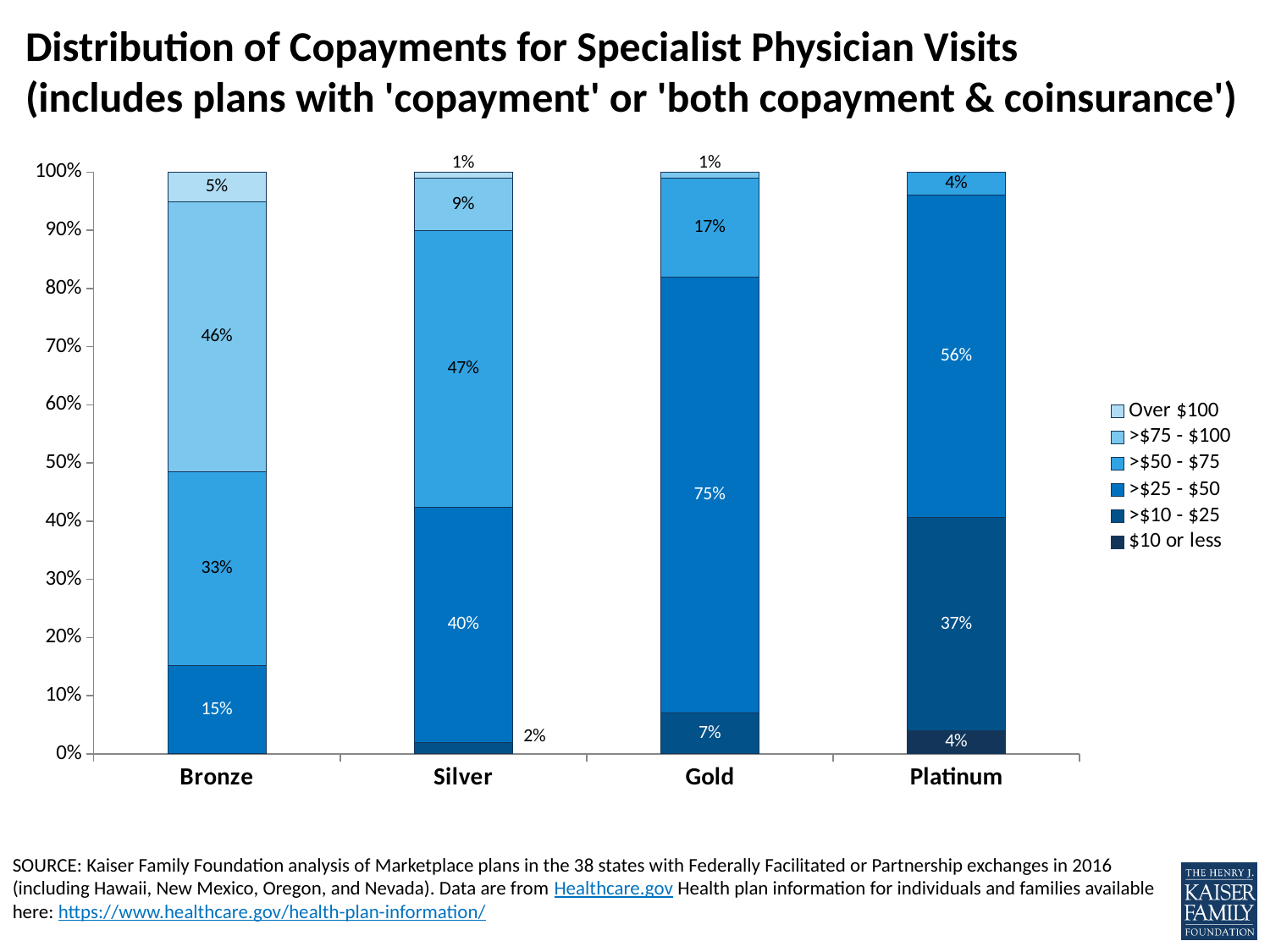
What is the value of the bottom segment of the Bronze bar? 15% What is the value of the bottom segment of the Platinum bar? 4% What is the difference between the largest segment in the Gold bar (75%) and the largest segment in the Platinum bar (56%)? 19 percentage points What is the value of the smallest segment in the Silver bar? 1% How many plan categories are shown on the x axis? 4 What is the first entry listed in the legend? Over $100 What is the value of the largest segment in the Platinum bar? 56% Which plan has the largest single segment in its bar? Gold What kind of chart is shown on the slide? Stacked bar chart What is the value of the largest segment in the Gold bar? 75% Which is larger: the 46% segment in the Bronze bar or the 47% segment in the Silver bar? Silver's 47% How many series does the legend list? 6